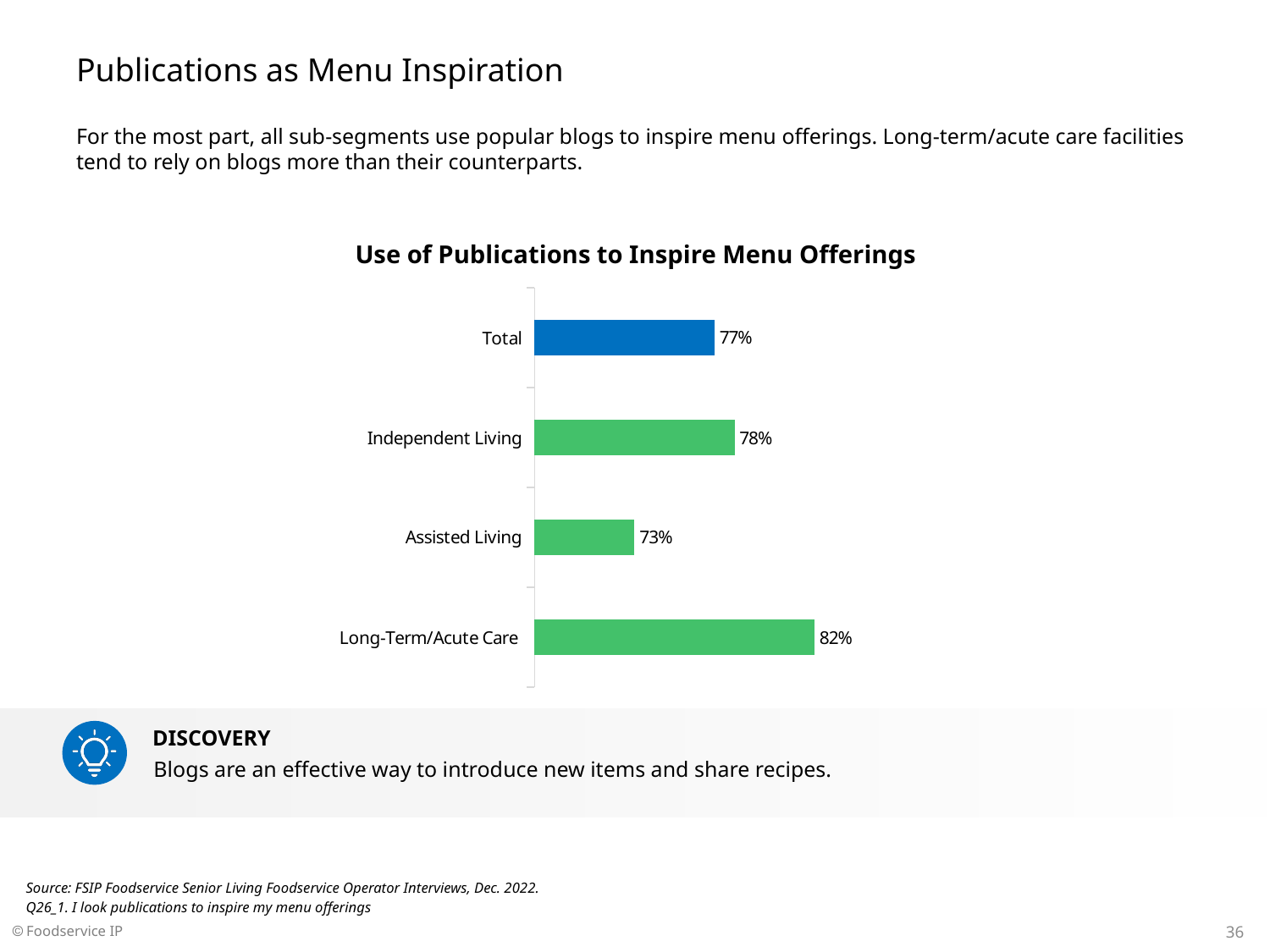
What kind of chart is shown on the slide? Bar chart How many categories are shown in the chart? 4 What is the value for Total? 77% What is the value for Assisted Living? 73% What is the value for Independent Living? 78% What is the value for Long-Term/Acute Care? 82% Which category has the lowest value? Assisted Living Which category has the highest value? Long-Term/Acute Care What is the difference between the values for Long-Term/Acute Care and Assisted Living? 9% What is the difference between the values for Independent Living and Total? 1% Which is larger, the value for Long-Term/Acute Care or the value for Independent Living? Long-Term/Acute Care What is the title of the chart? Use of Publications to Inspire Menu Offerings